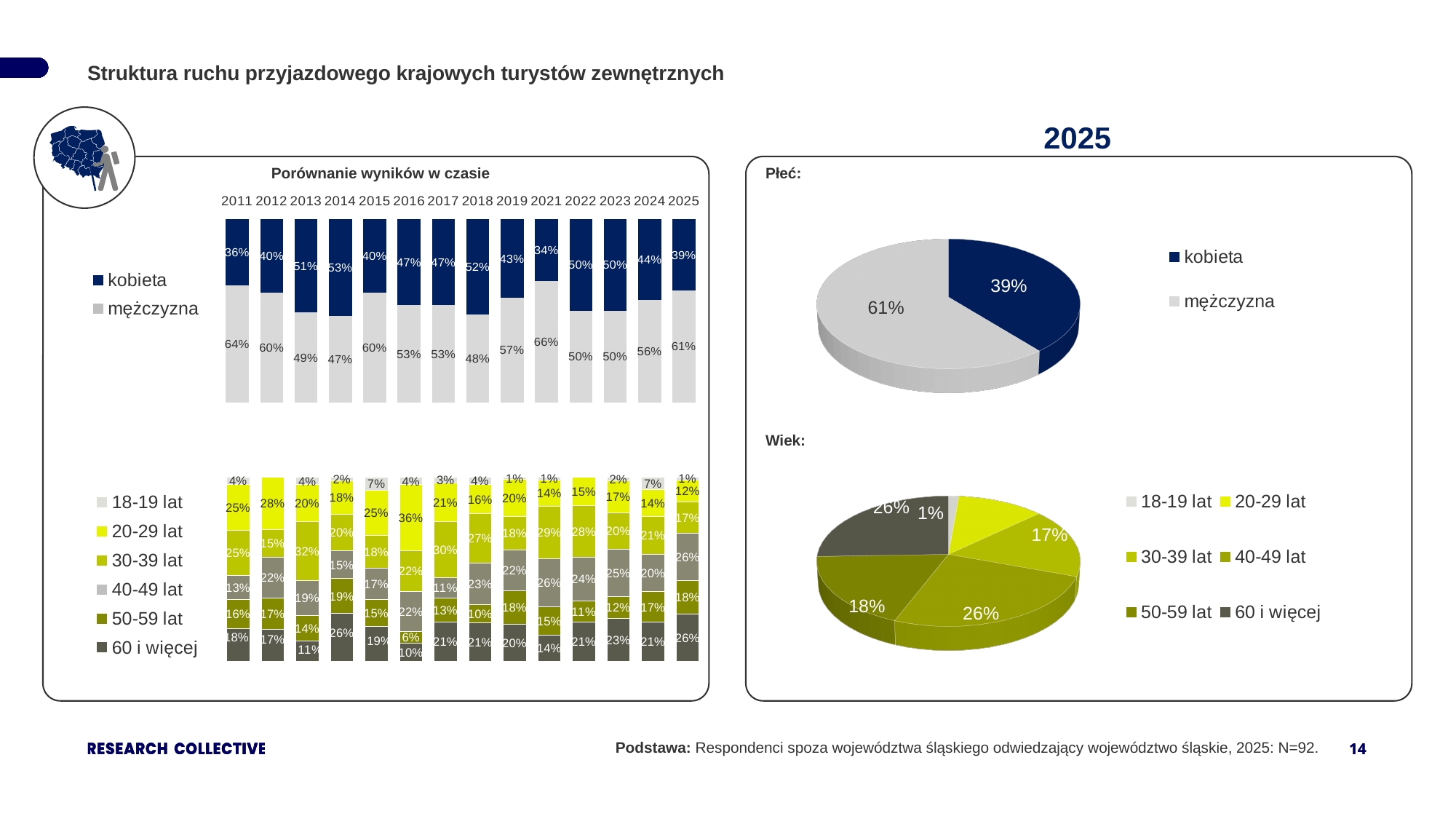
In the 'Wiek' pie chart for 2025 (bottom right), what is the difference between the 60 i więcej slice and the 30-39 lat slice? 9 percentage points In the 'Porównanie wyników w czasie' gender bar chart (top left), how many years are shown on the x axis? 14 In the 'Porównanie wyników w czasie' gender bar chart (top left), what is the value for mężczyzna in 2021? 66% In the 'Płeć' pie chart for 2025 (top right), which slice is larger, kobieta or mężczyzna? mężczyzna In the age-group bar chart on the left (bottom), what is the value for 20-29 lat in 2016? 36% In the 'Płeć' pie chart for 2025 (top right), what share does kobieta have? 39% In the age-group bar chart on the left (bottom), what is the value for 40-49 lat in 2025? 26% In the 'Porównanie wyników w czasie' gender bar chart (top left), which year has the highest share of mężczyzna? 2021 How many series does the legend of the age-group bar chart on the left (bottom) list? 6 In the 'Porównanie wyników w czasie' gender bar chart (top left), what is the value for kobieta in 2011? 36% In the 'Wiek' pie chart for 2025 (bottom right), what is the value for 50-59 lat? 18% What kind of chart is the 'Porównanie wyników w czasie' gender chart (top left)? Stacked bar chart